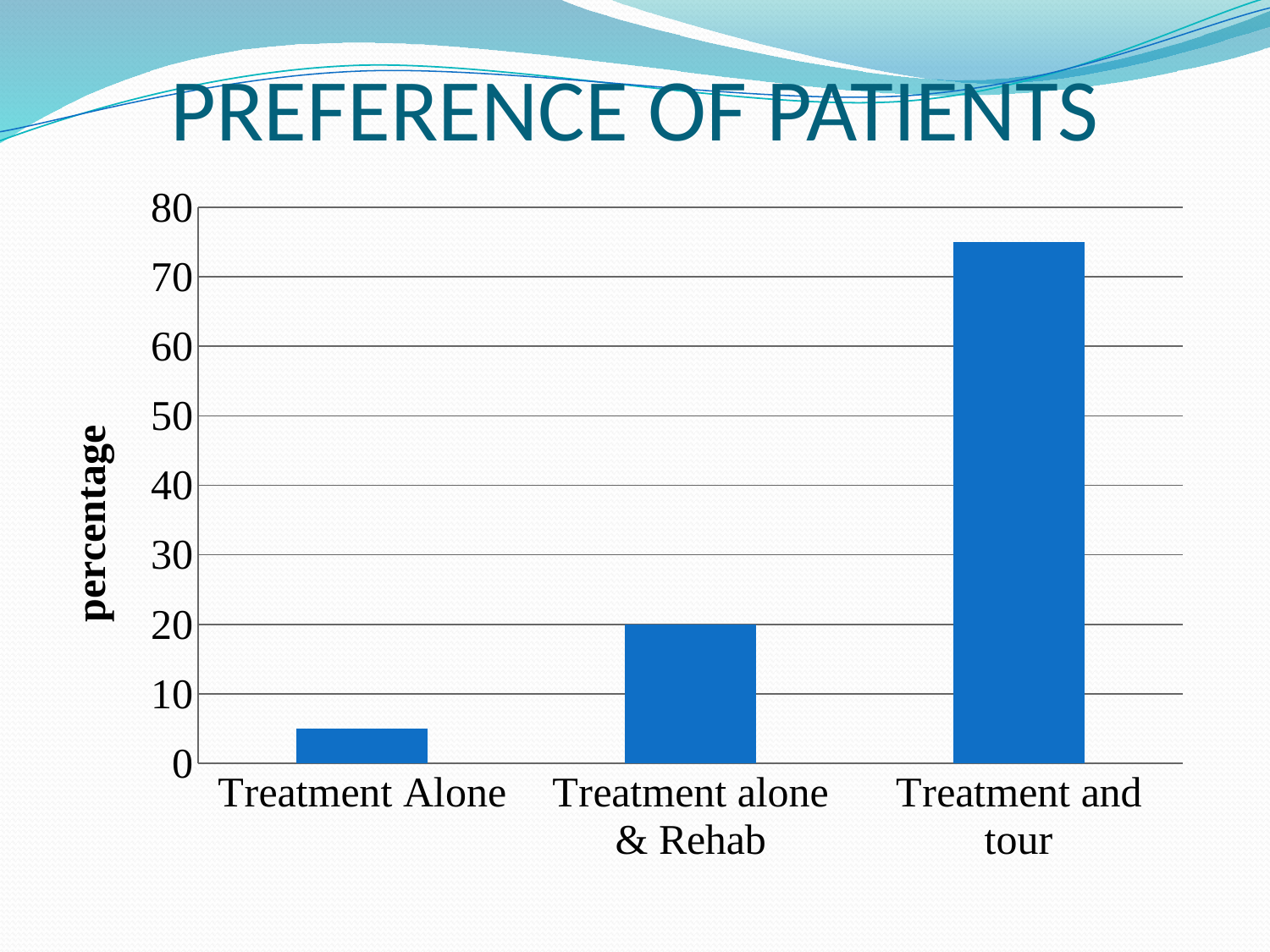
What is the title of the slide containing the chart? PREFERENCE OF PATIENTS What is the percentage for Treatment alone & Rehab? 20 Which category has the highest percentage? Treatment and tour Is the value for Treatment and tour greater or less than 80? less Do the values rise or fall moving from left to right along the x axis? rise Is the value for Treatment and tour greater or less than 70? greater Which category has the lowest percentage? Treatment Alone Is the value for Treatment Alone greater or less than 10? less Which is larger, the value for Treatment Alone or the value for Treatment alone & Rehab? Treatment alone & Rehab How many categories are shown on the x axis of the chart? 3 What kind of chart is shown on the slide? bar chart What is the label on the vertical axis of the chart? percentage